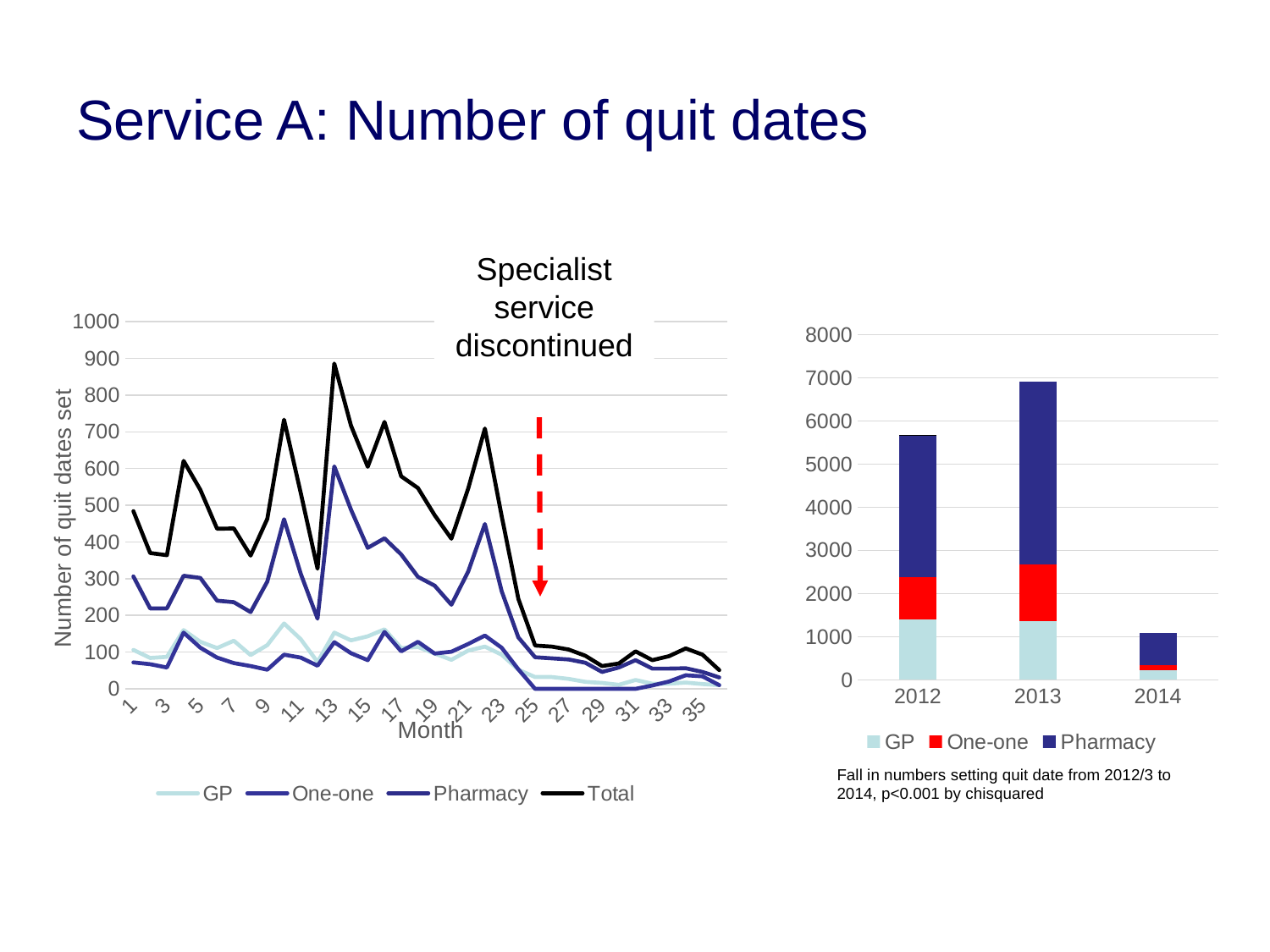
In the right chart, is the total for 2014 greater or less than 2000? less What kind of chart is the chart on the right of the slide? bar chart In the right chart, which year has the highest stacked bar total? 2013 How many series does the legend of the right chart list? 3 What is the y-axis title of the left chart? Number of quit dates set In the right chart, which year has the lowest stacked bar total? 2014 What kind of chart is the chart on the left of the slide? line chart How many years are shown on the x axis of the right chart? 3 In the right chart, is the total for 2013 greater or less than 6000? greater In the right chart, which year has the larger total, 2012 or 2013? 2013 In the left chart, is the Total value at month 13 greater or less than 800? greater How many series does the legend of the left chart list? 4